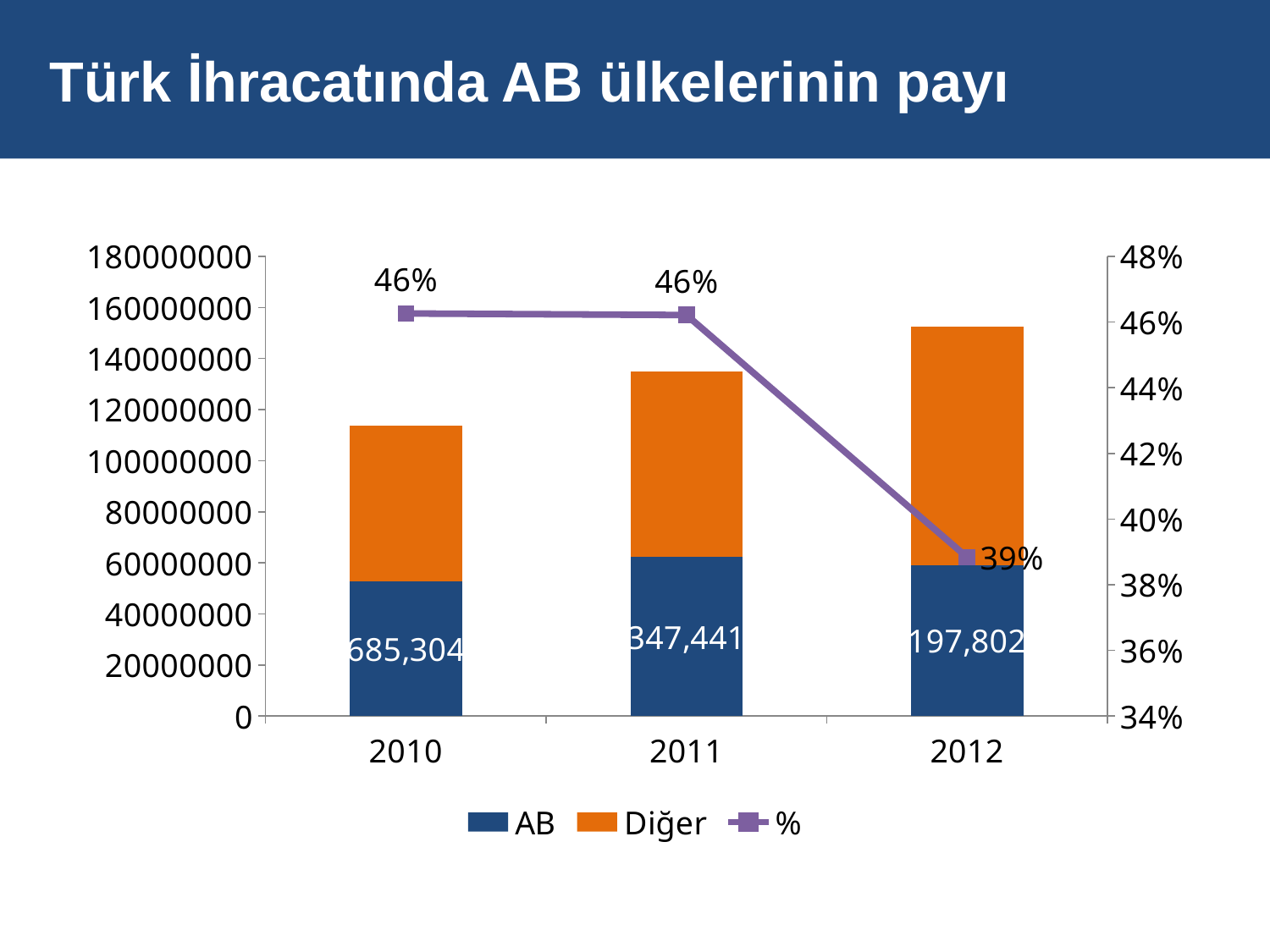
How many series does the legend list? 3 What is the difference between the % value for 2010 and the % value for 2012? 7% Which year has the larger % value, 2011 or 2012? 2011 Is the total height of the stacked bar for 2012 greater or less than 140000000? greater Which year has the tallest stacked bar? 2012 Does the % line rise or fall from 2010 to 2012? fall What is the value of the % series for 2012? 39% Which year has the lowest value on the % line? 2012 What is the value of the % series for 2010? 46% Is the total height of the stacked bar for 2010 greater or less than 120000000? less What is the title of the slide? Türk İhracatında AB ülkelerinin payı How many years are shown on the x axis? 3